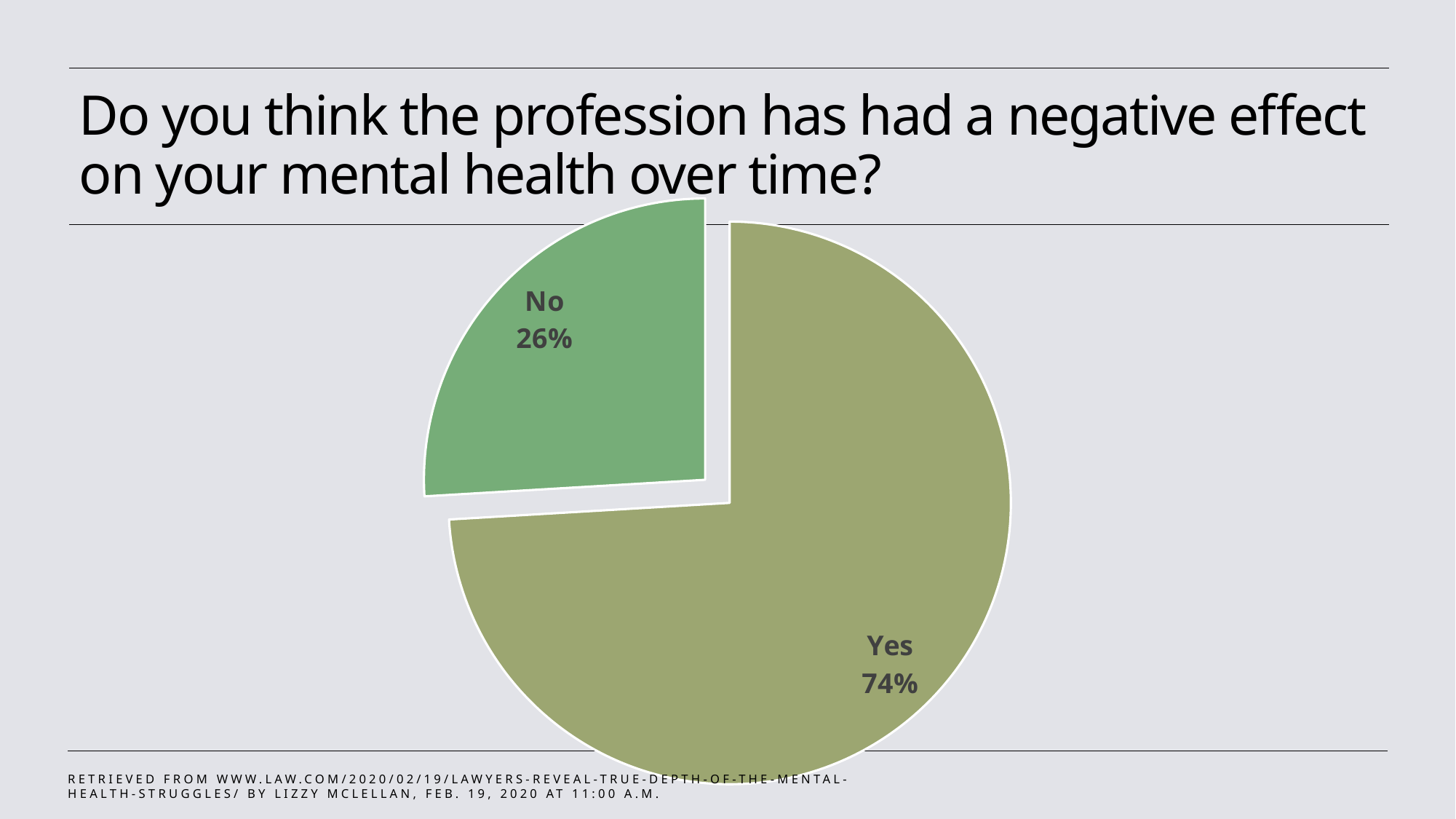
What share of respondents answered "No"? 26% Which is larger, the "Yes" slice or the "No" slice? Yes Which slice is pulled out (exploded) from the pie? No What share of respondents answered "Yes"? 74% What question does the chart title ask? Do you think the profession has had a negative effect on your mental health over time? How many slices does the pie chart have? 2 Which response has the smallest slice of the pie? No What kind of chart is shown on the slide? pie chart Is the share for "No" greater or less than 50%? less What is the difference in percentage points between the "Yes" and "No" slices? 48 Which response has the largest slice of the pie? Yes